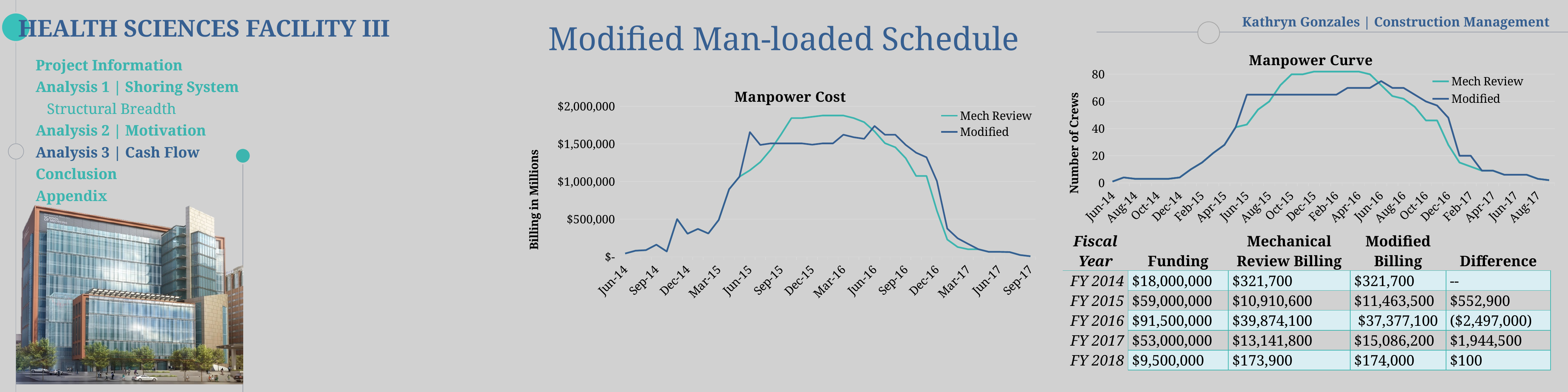
In the Manpower Cost chart, does the Mech Review line rise or fall from Jun-16 to Mar-17? fall How many series does the legend of the Manpower Curve chart list? 2 In the Manpower Curve chart, which series has the larger value at Jun-15, Mech Review or Modified? Modified What kind of chart is the Manpower Cost chart? line chart In the Manpower Cost chart, which series has the larger value at Dec-15, Mech Review or Modified? Mech Review In the Manpower Cost chart, which series has the larger value at Jun-15, Mech Review or Modified? Modified In the Manpower Curve chart, is the Modified value at Feb-15 greater or less than 20? less In the Manpower Cost chart, is the Mech Review value at Mar-17 greater or less than $500,000? less What is the y-axis title of the Manpower Curve chart? Number of Crews In the Manpower Cost chart, is the Mech Review value at Dec-15 greater or less than $1,500,000? greater